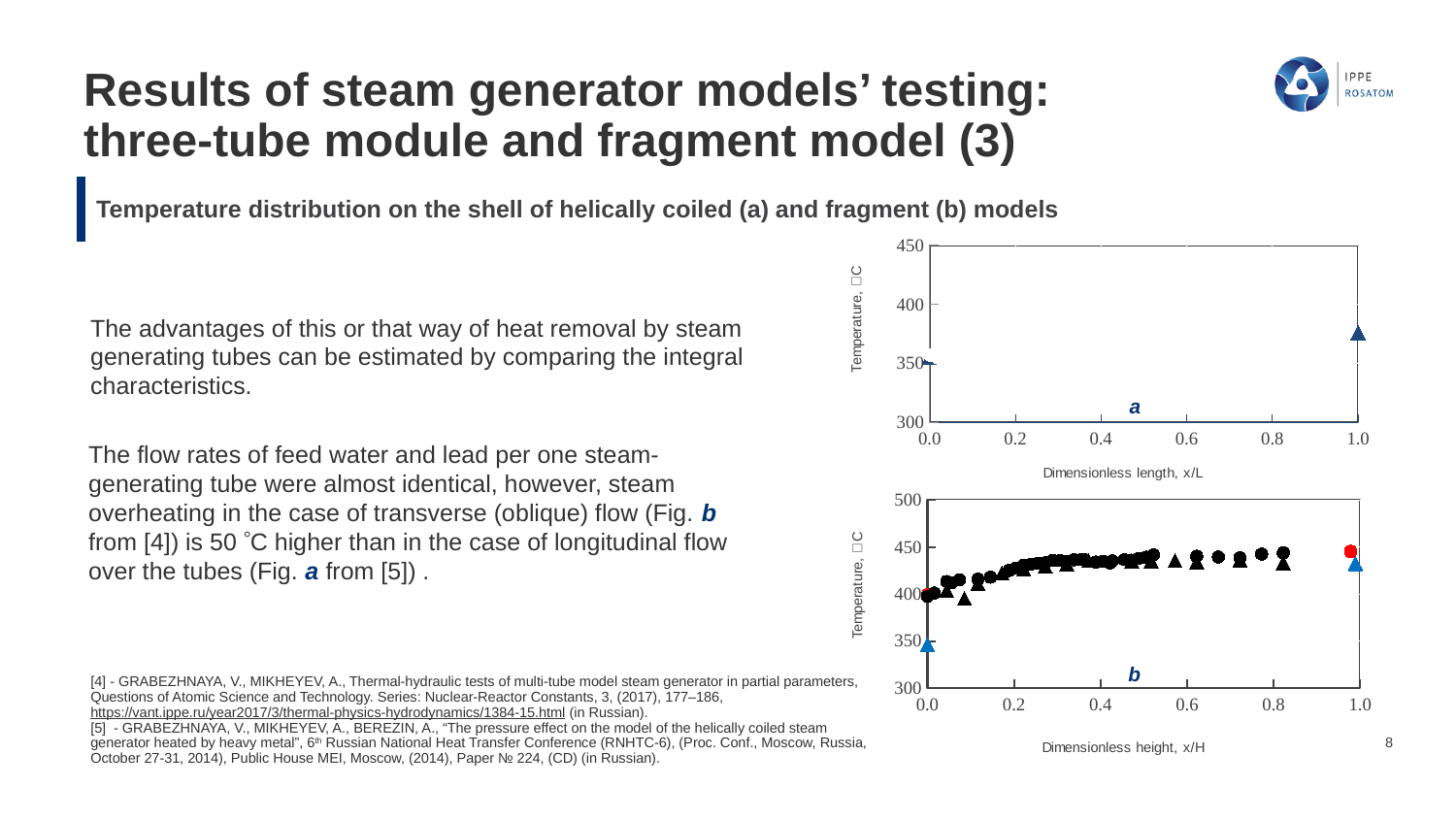
In the top chart (a), is the temperature at x/L = 1.0 greater or less than 400? less What is the x-axis label of the top chart (a)? Dimensionless length, x/L In the bottom chart (b), is the temperature of the blue triangle at x/H = 0.0 greater or less than 400? less In the bottom chart (b), is the temperature of the red circle near x/H = 1.0 greater or less than 400? greater What kind of chart is the bottom chart (b)? scatter chart In the bottom chart (b), do the black data points rise or fall as the dimensionless height x/H increases? rise In the top chart (a), which point has the higher temperature, the one at x/L = 0.0 or the one at x/L = 1.0? x/L = 1.0 What kind of chart is the top chart (a)? scatter chart What is the x-axis label of the bottom chart (b)? Dimensionless height, x/H In the bottom chart (b), which is higher near x/H = 1.0, the red circle or the blue triangle? red circle